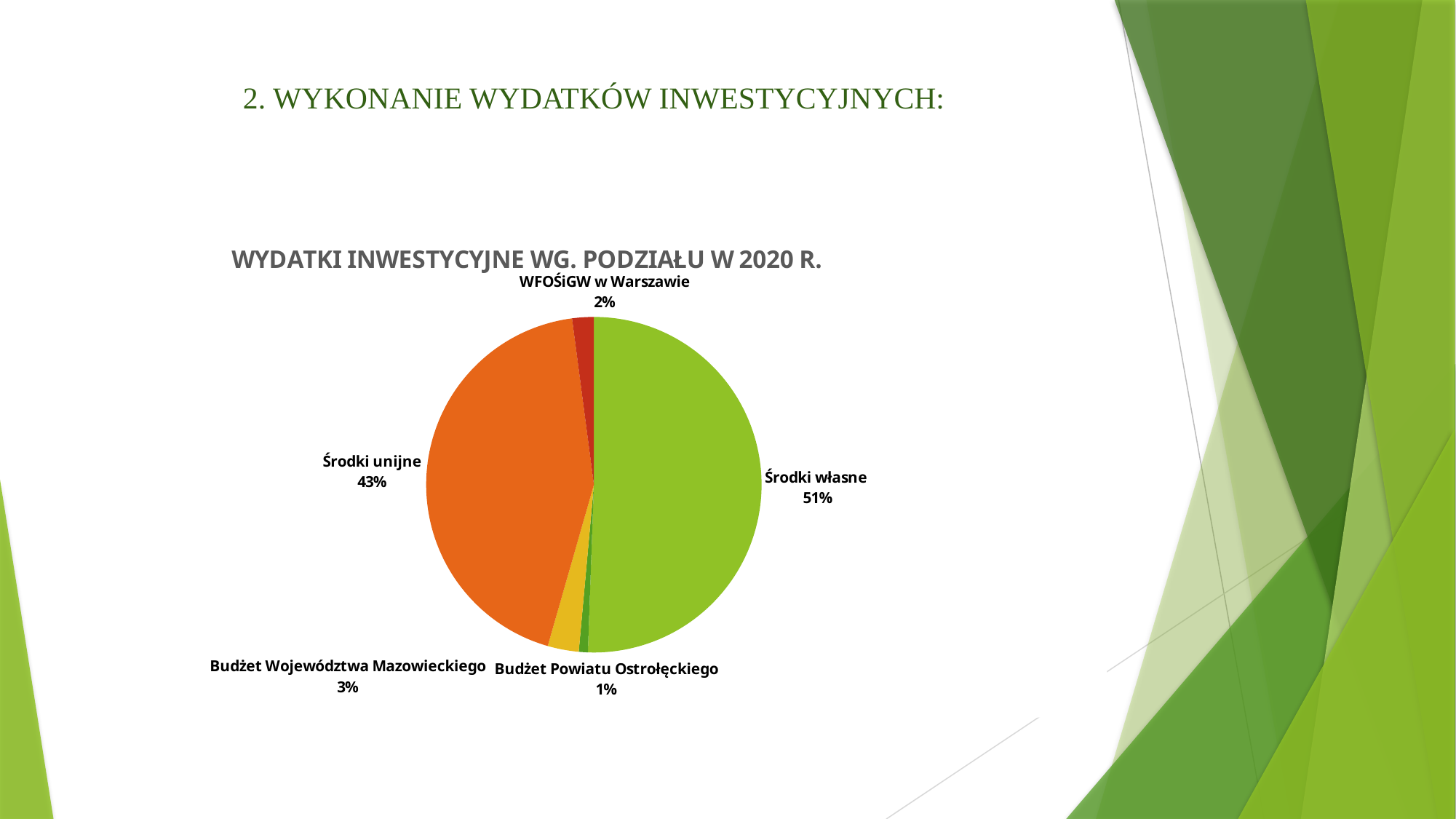
Which category has the largest share of the pie? Środki własne What share of the pie does Budżet Powiatu Ostrołęckiego have? 1% What is the difference in percentage points between Środki własne and Środki unijne? 8 What is the title of the chart? WYDATKI INWESTYCYJNE WG. PODZIAŁU W 2020 R. What share of the pie does Środki unijne have? 43% How many categories are shown in the pie chart? 5 What share of the pie does Budżet Województwa Mazowieckiego have? 3% Which is larger, the share for Budżet Województwa Mazowieckiego or the share for WFOŚiGW w Warszawie? Budżet Województwa Mazowieckiego What kind of chart is shown on the slide? pie chart Which category has the smallest share of the pie? Budżet Powiatu Ostrołęckiego